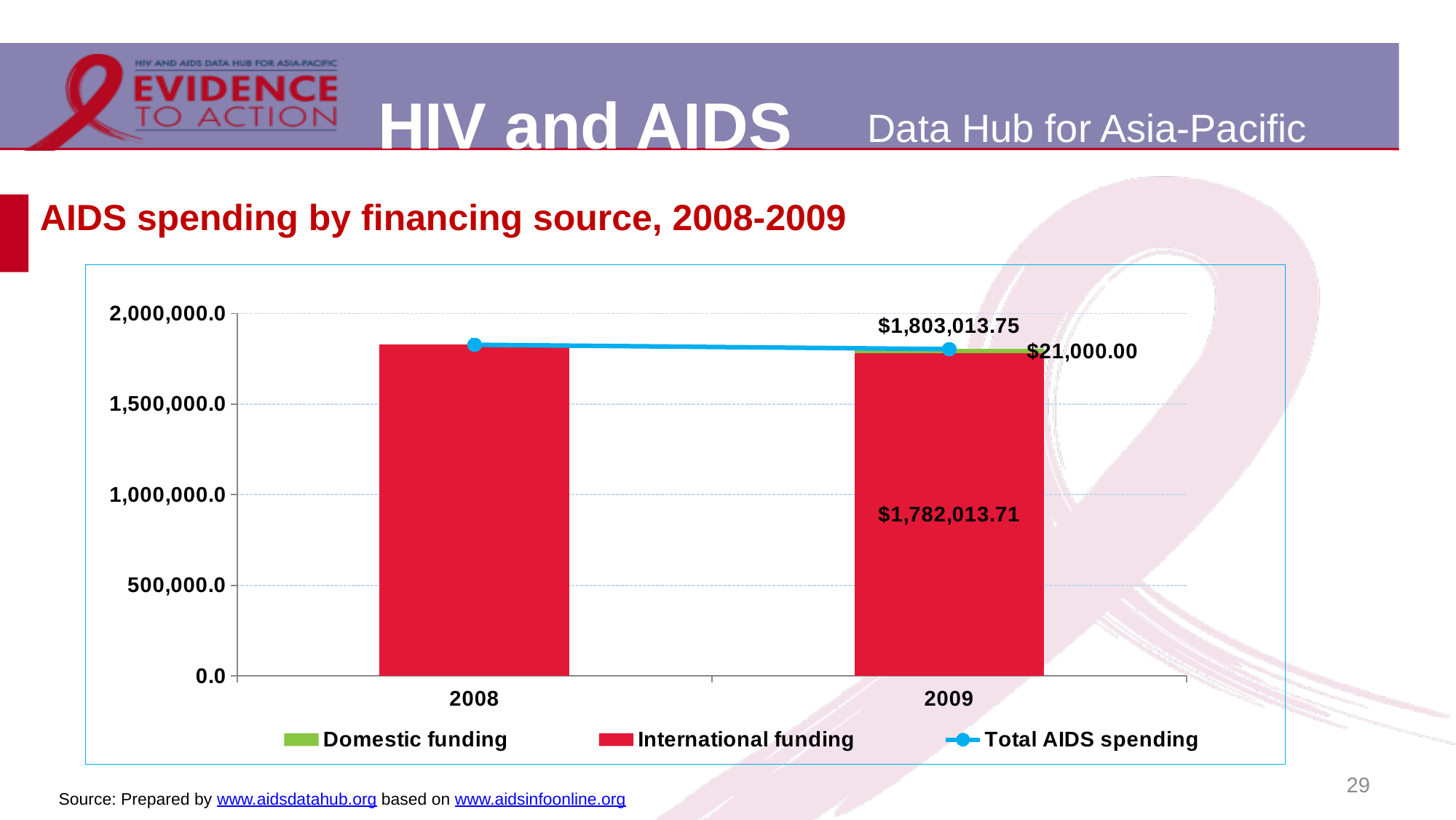
How many series does the legend list? 3 What kind of chart is used to show the funding sources? Bar chart Which series is shown as a line with markers? Total AIDS spending What is the title of the chart? AIDS spending by financing source, 2008-2009 What is the difference between International funding and Domestic funding in 2009? $1,761,013.71 Is the International funding for 2008 greater or less than 1,500,000? greater What is the value of International funding for 2009? $1,782,013.71 What is the value of Domestic funding for 2009? $21,000.00 In 2009, which is larger: International funding or Domestic funding? International funding What is the total of the stacked bar for 2009? $1,803,013.71 What is the Total AIDS spending for 2009? $1,803,013.75 How many years are shown on the x axis of the chart? 2